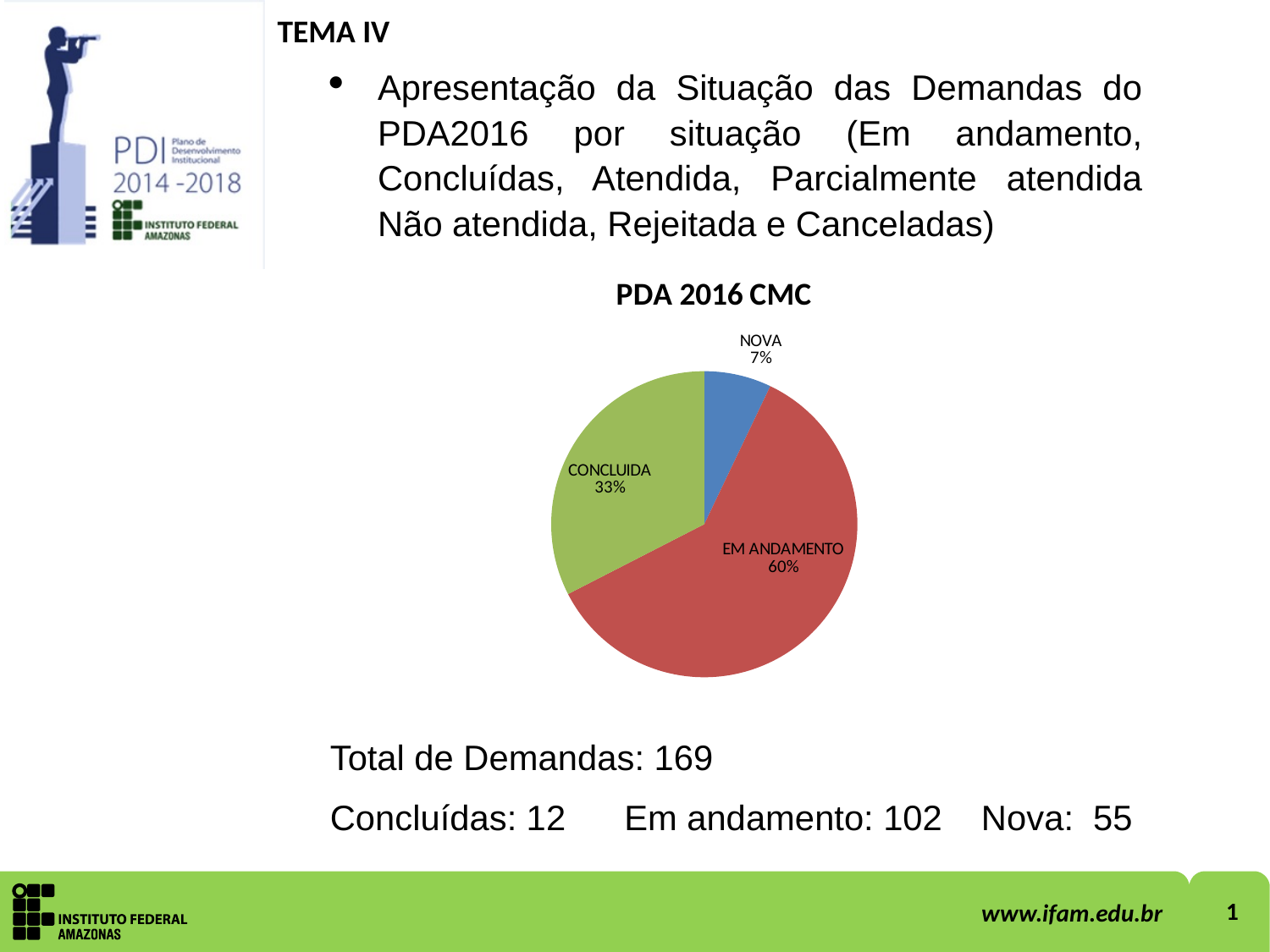
What is the difference in percentage points between the EM ANDAMENTO and CONCLUIDA slices? 27 Which slice has the largest share of the pie? EM ANDAMENTO What percentage is shown for the EM ANDAMENTO slice? 60% What share of the pie does the CONCLUIDA slice represent? 33% How many slices does the pie chart have? 3 Which slice is larger, CONCLUIDA or NOVA? CONCLUIDA What percentage is shown for the CONCLUIDA slice? 33% What percentage is shown for the NOVA slice? 7% What type of chart is shown on the slide? pie chart What is the title of the chart? PDA 2016 CMC What colour is the EM ANDAMENTO slice? red Which slice has the smallest share of the pie? NOVA